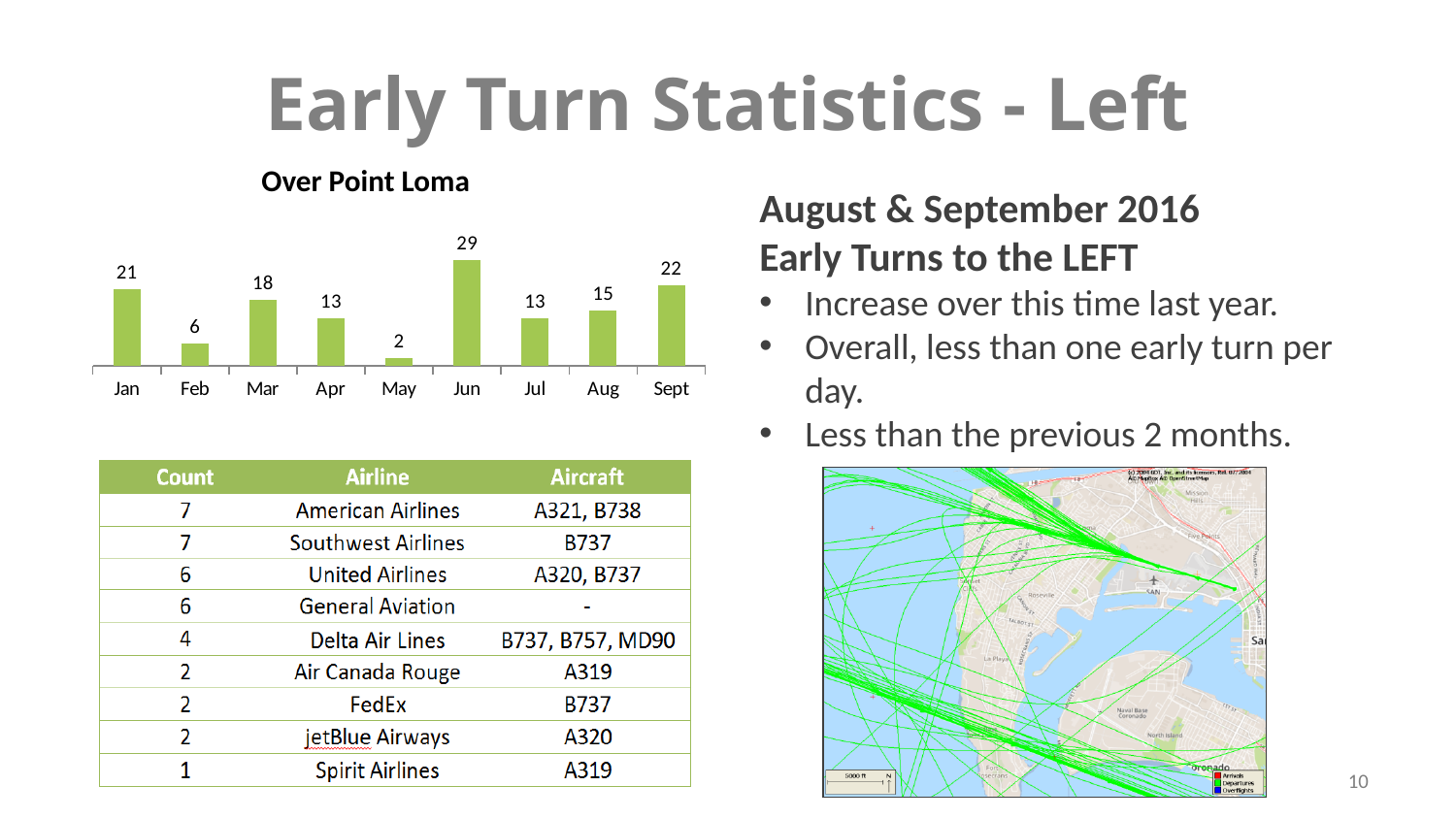
In the 'Over Point Loma' chart, which is larger, the value for Jan or the value for Mar? Jan How many months are shown on the x axis of the 'Over Point Loma' chart? 9 What is the title of the chart on the slide? Over Point Loma In the 'Over Point Loma' chart, do the values rise or fall from Jul to Sept? rise What is the value for Feb in the 'Over Point Loma' chart? 6 In the 'Over Point Loma' chart, what is the difference between the values for Sept and Aug? 7 Which month has the lowest value in the 'Over Point Loma' chart? May What is the value for Jun in the 'Over Point Loma' chart? 29 Which month has the highest value in the 'Over Point Loma' chart? Jun What kind of chart is the 'Over Point Loma' chart? bar chart In the 'Over Point Loma' chart, what is the difference between the values for Jun and May? 27 What is the value for Sept in the 'Over Point Loma' chart? 22